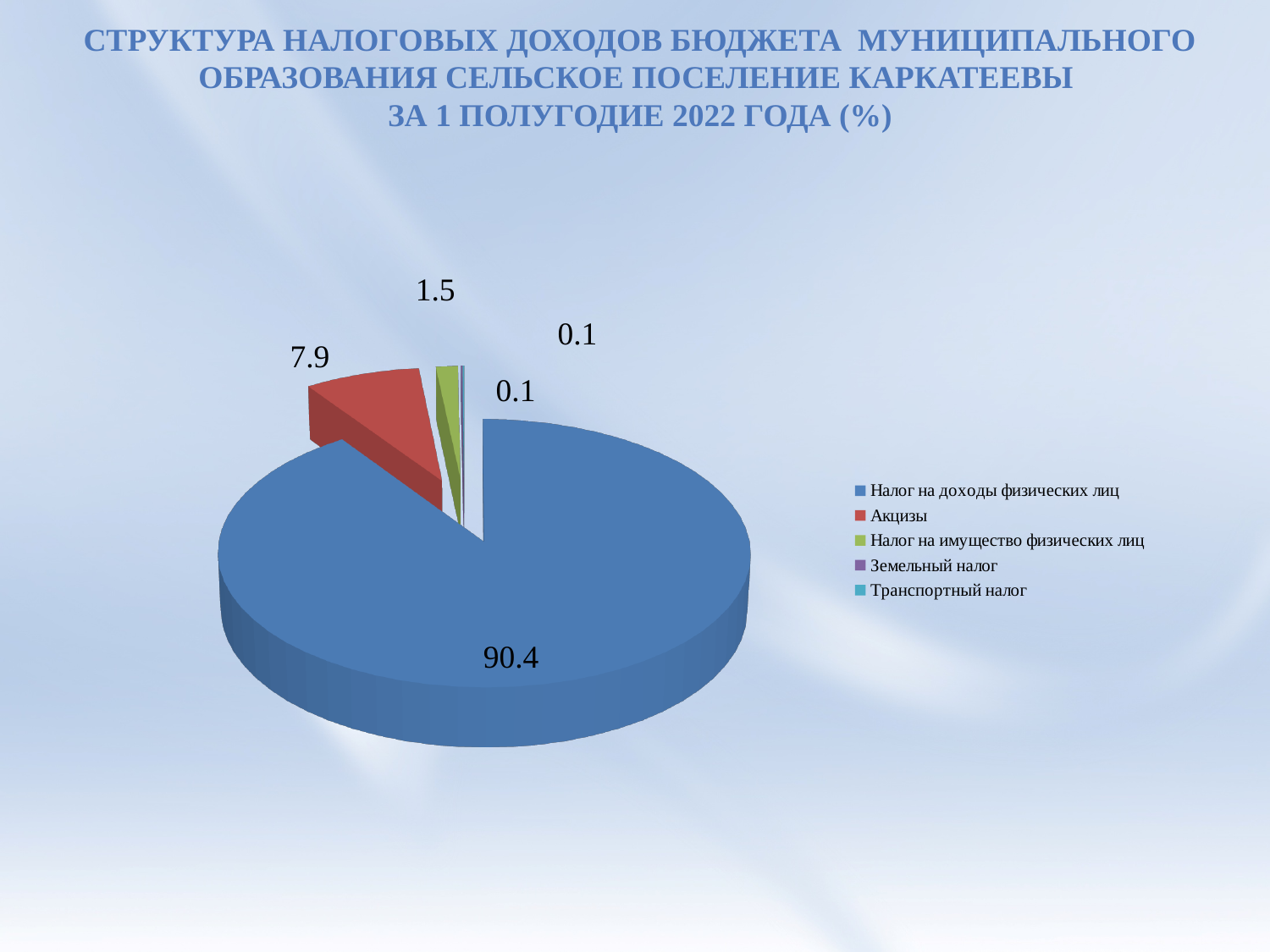
What is the difference between the values for Акцизы and Налог на имущество физических лиц? 6.4 What is the difference between the values for Налог на доходы физических лиц and Акцизы? 82.5 Which is larger, the value for Акцизы or the value for Налог на имущество физических лиц? Акцизы How many categories does the legend list? 5 What is the value for Налог на доходы физических лиц? 90.4 What is the value for Транспортный налог? 0.1 What is the value for Земельный налог? 0.1 What colour is the slice for Акцизы? red What kind of chart is shown on the slide? pie chart What is the value for Налог на имущество физических лиц? 1.5 Which category has the largest share of the pie? Налог на доходы физических лиц What is the value for Акцизы? 7.9